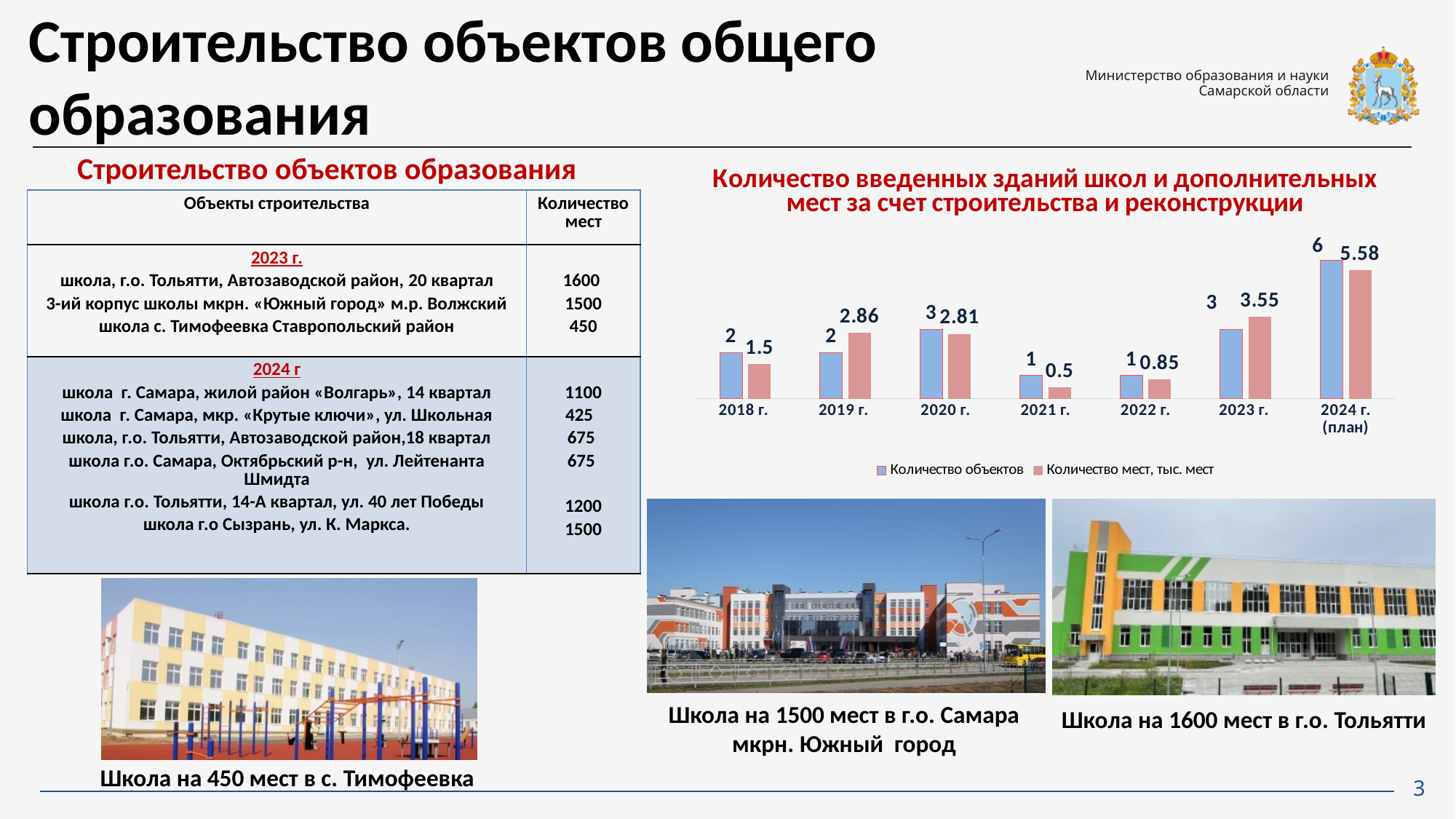
What is the value of "Количество объектов" for 2024 г. (план)? 6 Which is larger: "Количество мест, тыс. мест" for 2019 г. or for 2020 г.? 2019 г. What is the value of "Количество мест, тыс. мест" for 2019 г.? 2.86 How does "Количество объектов" change from 2022 г. to 2024 г. (план)? rises What is the difference in "Количество мест, тыс. мест" between 2024 г. (план) and 2023 г.? 2.03 What colour are the bars for "Количество объектов" in the chart? blue Which year has the lowest value of "Количество мест, тыс. мест"? 2021 г. What is the value of "Количество мест, тыс. мест" for 2021 г.? 0.5 Which year has the highest value of "Количество мест, тыс. мест"? 2024 г. (план) How many year categories are shown on the x axis of the chart? 7 How many series does the chart legend list? 2 What kind of chart is shown on the slide? bar chart